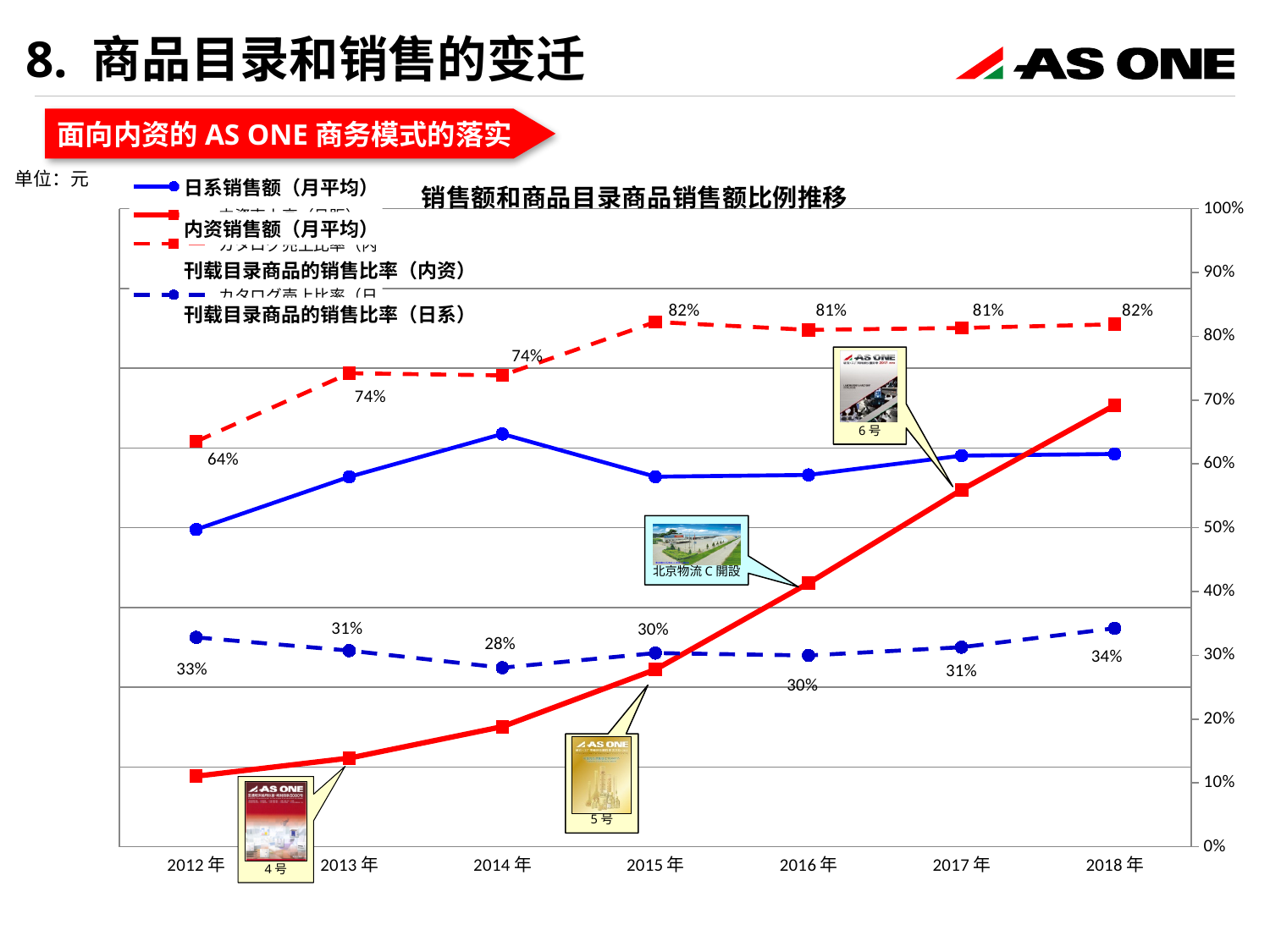
How many years are plotted on the x axis? 7 What is the value of 刊载目录商品的销售比率（内资） in 2015年? 82% In which year is 刊载目录商品的销售比率（内资） lowest? 2012年 In which year is 刊载目录商品的销售比率（日系） highest? 2018年 In 2013年, which is larger: 刊载目录商品的销售比率（内资） or 刊载目录商品的销售比率（日系）? 刊载目录商品的销售比率（内资） How many series does the legend list? 4 What is the value of 刊载目录商品的销售比率（日系） in 2014年? 28% What is the difference between 刊载目录商品的销售比率（内资） and 刊载目录商品的销售比率（日系） in 2018年? 48 percentage points In which year is 刊载目录商品的销售比率（日系） lowest? 2014年 What kind of chart is shown on the slide? line chart